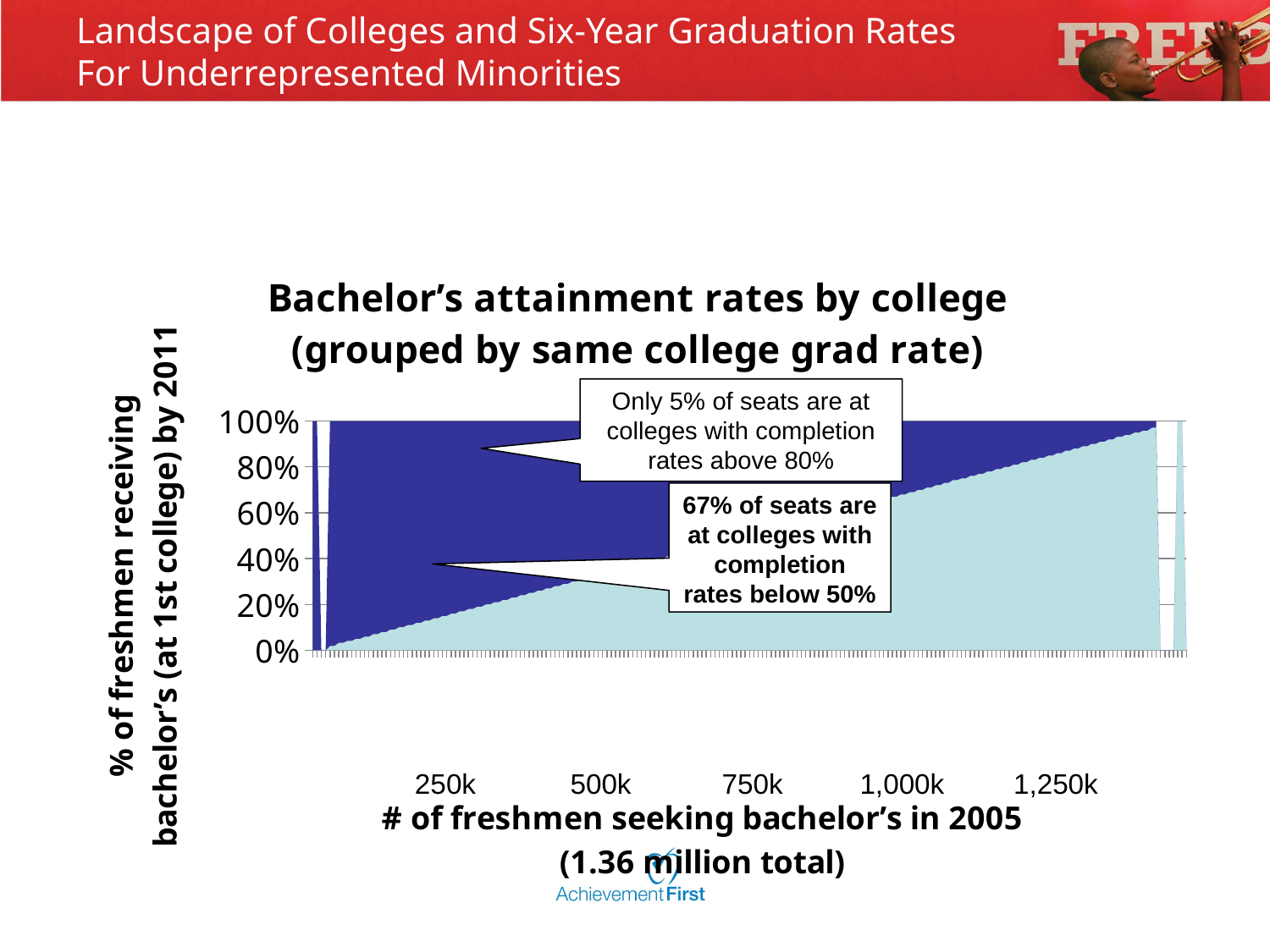
What is the difference between the share of seats at colleges with completion rates below 50% and the share at colleges with completion rates above 80%? 62% Which is larger: the share of seats at colleges with completion rates below 50% or the share at colleges with completion rates above 80%? below 50% According to the chart, what is the total number of freshmen seeking bachelor's in 2005? 1.36 million According to the callout on the chart, what percentage of seats are at colleges with completion rates below 50%? 67% What kind of chart is shown on the slide? area chart How many tick labels are shown on the x axis of the chart? 5 What is the highest value labelled on the y axis of the chart? 100% What is the label of the x axis of the chart? # of freshmen seeking bachelor's in 2005 (1.36 million total) According to the callout on the chart, what percentage of seats are at colleges with completion rates above 80%? 5% What is the highest value labelled on the x axis of the chart? 1,250k Does the dark blue portion of the bars rise or fall moving left to right along the x axis? fall What is the title of the chart? Bachelor's attainment rates by college (grouped by same college grad rate)